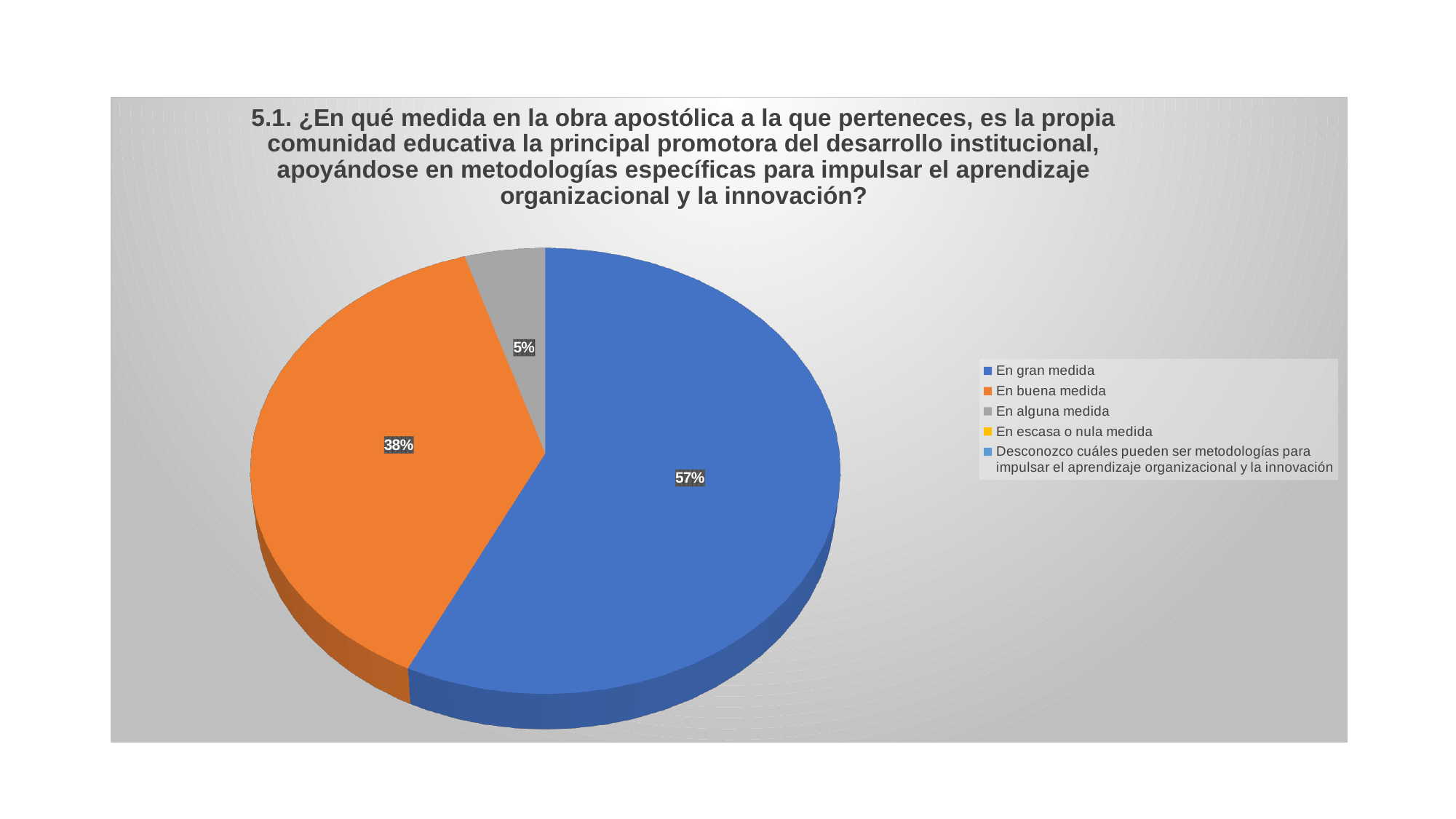
Is the share for 'En gran medida' greater or less than 50%? greater Which is larger: the share for 'En buena medida' or the share for 'En alguna medida'? En buena medida How many entries does the legend list? 5 What percentage of the pie chart corresponds to 'En gran medida'? 57% What is the difference in percentage points between 'En gran medida' and 'En buena medida'? 19 Among the slices with visible labels, which category has the smallest share? En alguna medida What kind of chart is shown on the slide? Pie chart What percentage of the pie chart corresponds to 'En buena medida'? 38% Which category has the largest share of the pie chart? En gran medida What colour is the slice for 'En gran medida'? Blue What percentage of the pie chart corresponds to 'En alguna medida'? 5% What colour is the slice for 'En buena medida'? Orange